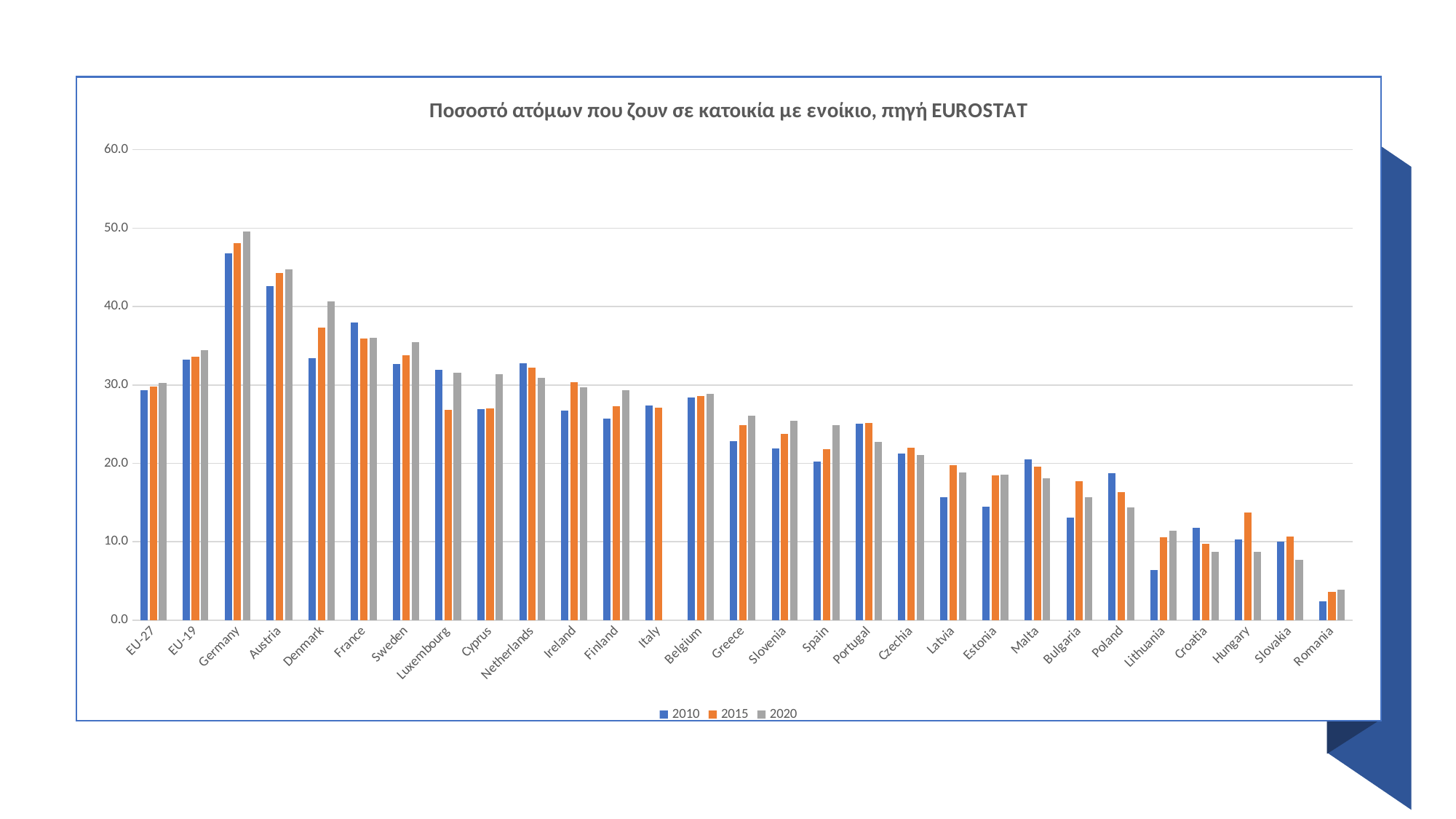
Which is larger for Denmark: the 2010 value or the 2020 value? 2020 Is the value for Hungary in 2015 greater or less than 10.0? greater What kind of chart is shown on the slide? bar chart Which country has the lowest value for 2010? Romania Which country has the highest value for 2020? Germany Is the value for Austria in 2020 greater or less than 40.0? greater How many series does the legend list? 3 Which is larger for Poland: the 2010 value or the 2020 value? 2010 Is the value for France in 2010 greater or less than 40.0? less Do the 2010 values generally rise or fall moving from left to right along the x axis? fall How many countries/regions are shown along the x axis? 29